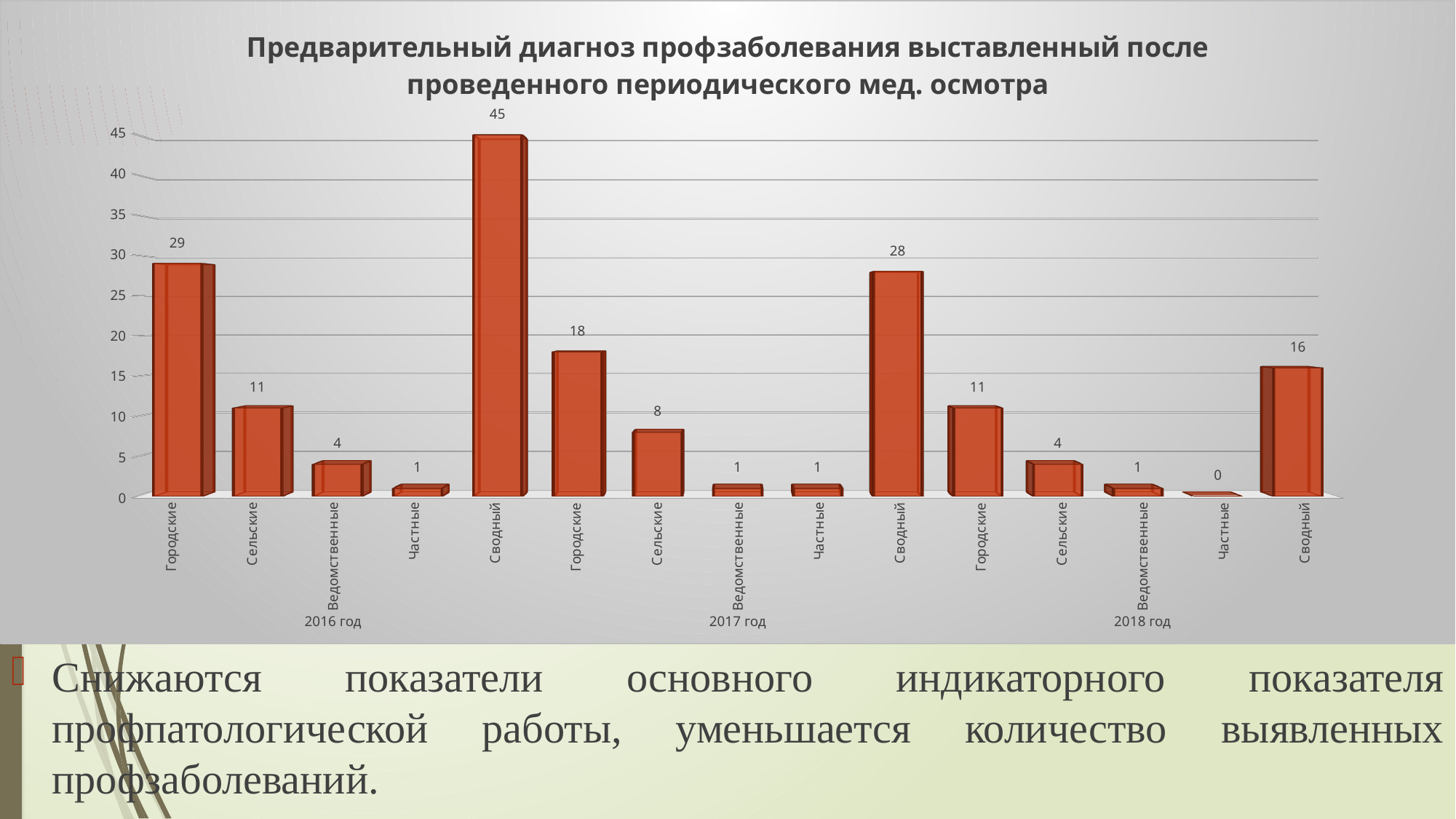
How many bars are plotted on the chart? 15 What is the difference between Городские and Сельские in 2018 год? 7 How many year groups are shown on the x axis? 3 What is the difference between the Сводный values for 2016 год and 2018 год? 29 What is the value for Городские in 2017 год? 18 How does the Сводный value change from 2016 год to 2018 год? It falls Which bar has the lowest value on the chart? Частные, 2018 год What is the value for Сводный in 2016 год? 45 Which is larger: Городские in 2016 год or Сводный in 2017 год? Городские in 2016 год Which bar has the highest value on the chart? Сводный, 2016 год What kind of chart is shown on the slide? Bar chart What is the value for Частные in 2018 год? 0